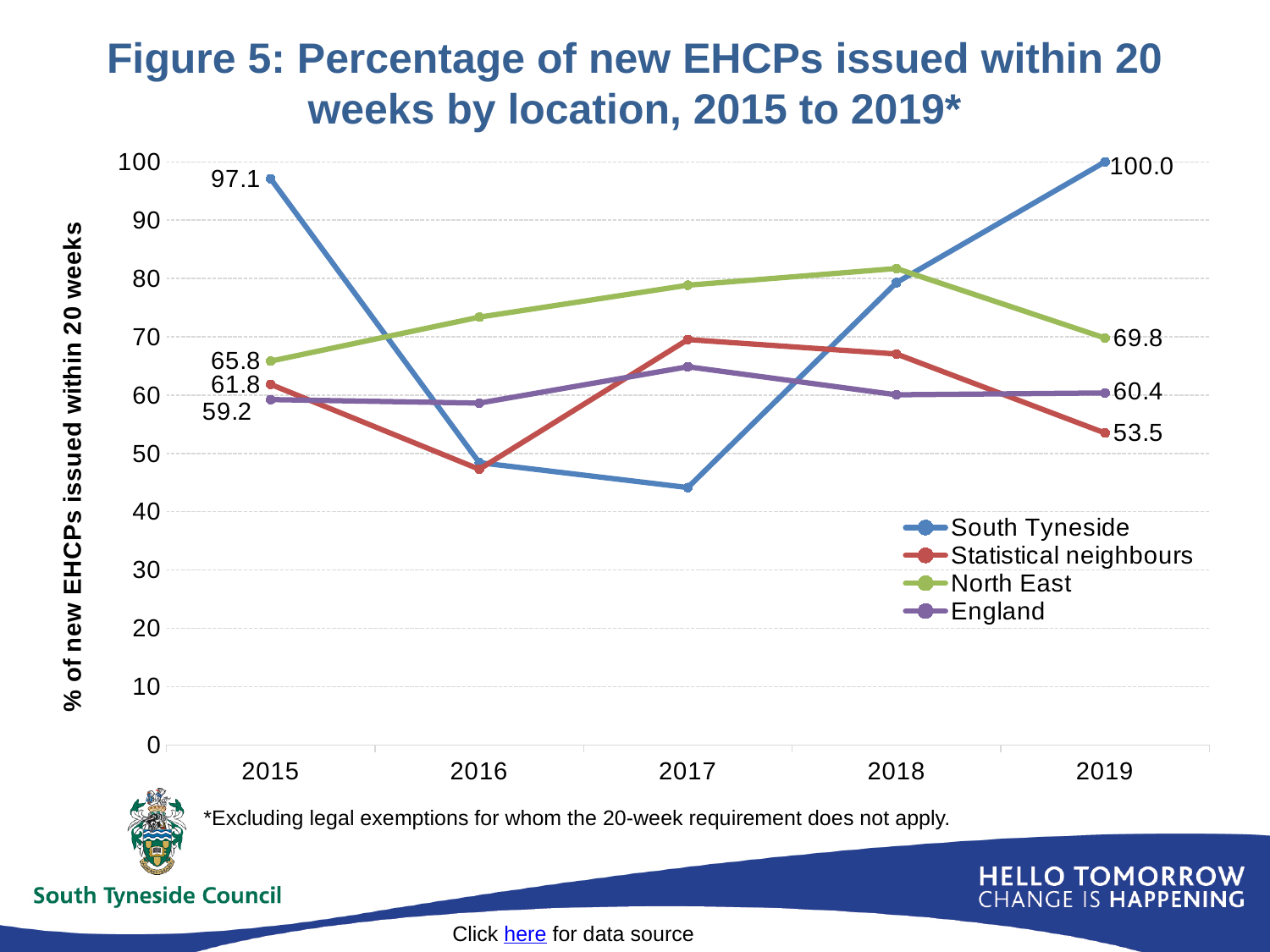
What value is shown for Statistical neighbours in 2015? 61.8 Is the North East value for 2018 greater or less than 80? greater By how much did the South Tyneside value increase from 2015 to 2019? 2.9 Which location had the lowest value in 2019? Statistical neighbours In 2015, which was higher: the North East or England? North East What value is shown for South Tyneside in 2019? 100.0 What was the percentage of new EHCPs issued within 20 weeks for South Tyneside in 2015? 97.1 What is the difference between the North East value in 2019 and in 2015? 4.0 What kind of chart is shown on the slide? Line chart What value is shown for the North East in 2019? 69.8 How many series does the legend list? 4 Is the South Tyneside value for 2017 greater or less than 50? less